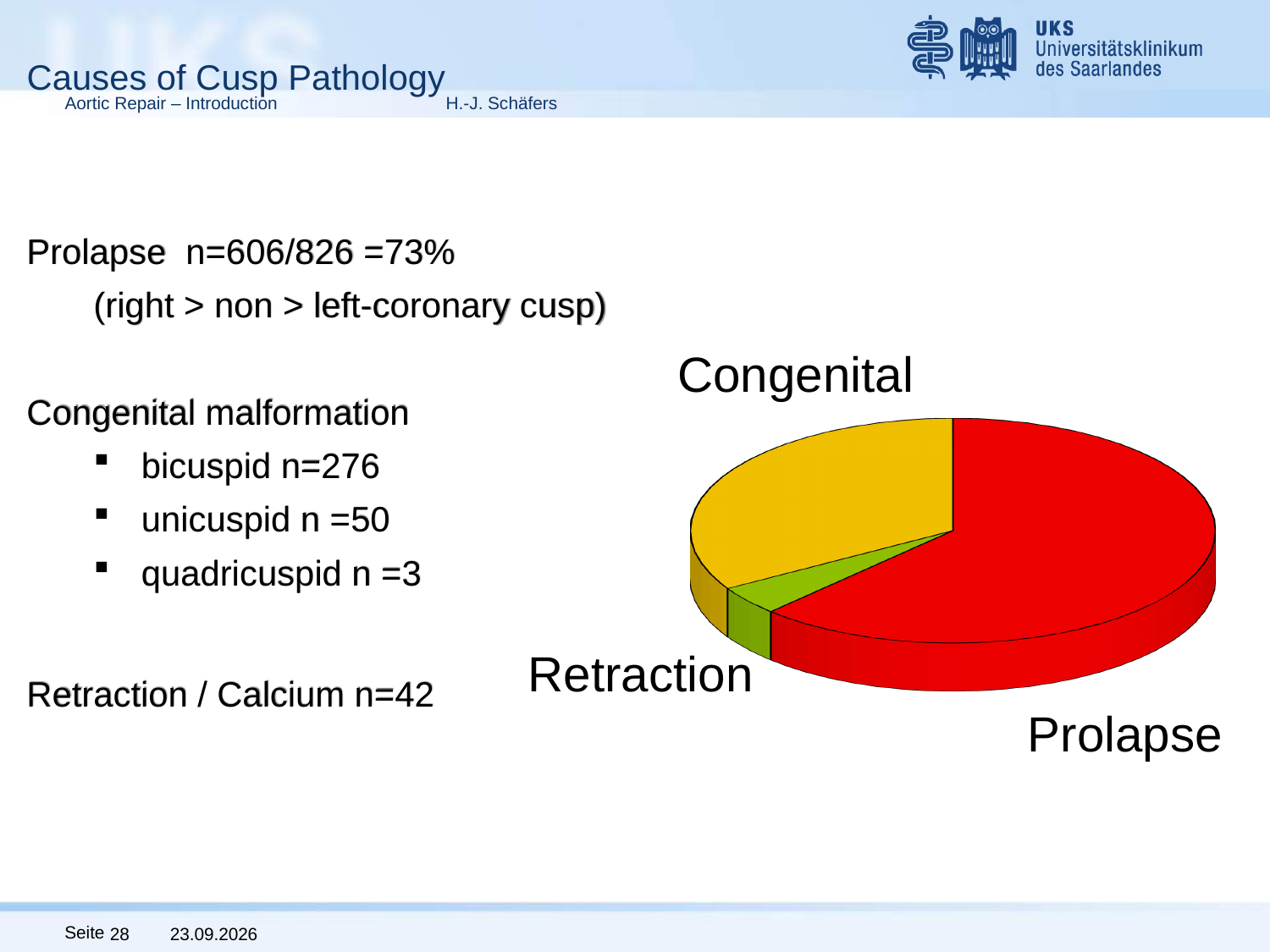
Is the Retraction slice greater or less than a quarter of the pie? less According to the slide, what share of cases does the Prolapse slice represent? 73% What colour is the Congenital slice in the pie chart? yellow What kind of chart is shown on the slide? pie chart What colour is the Prolapse slice in the pie chart? red Which slice is larger in the pie chart, Prolapse or Congenital? Prolapse Is the Prolapse slice greater or less than half of the pie? greater Which slice is larger in the pie chart, Congenital or Retraction? Congenital Which slice of the pie chart is the smallest? Retraction Which slice of the pie chart is the largest? Prolapse How many slices does the pie chart have? 3